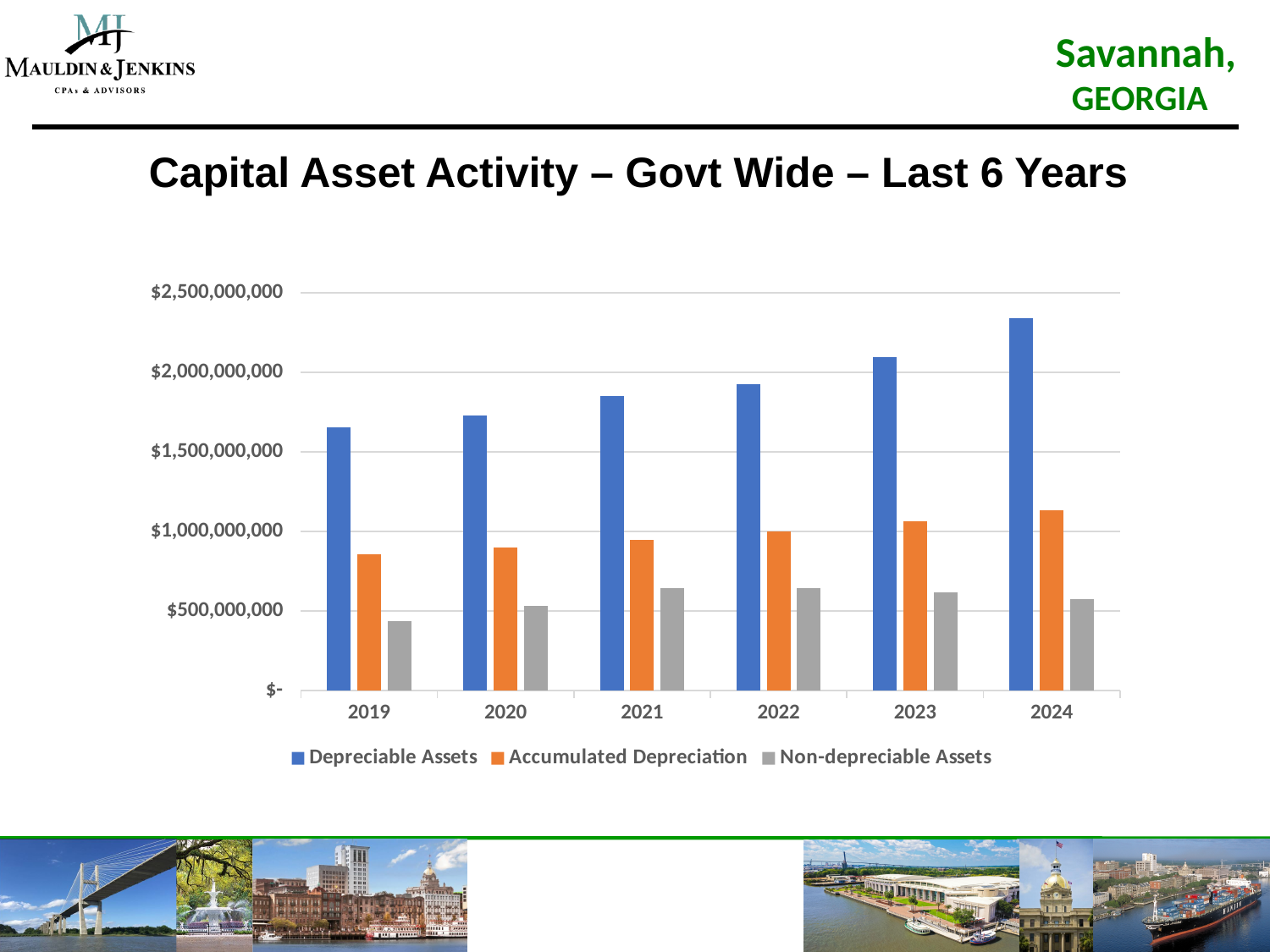
How many series does the chart's legend list? 3 Which year has the highest Depreciable Assets value? 2024 How many years are shown on the x axis of the chart? 6 Is the Depreciable Assets value for 2023 greater or less than $2,000,000,000? greater Is the Accumulated Depreciation value for 2019 greater or less than $1,000,000,000? less Which year has the lowest Non-depreciable Assets value? 2019 Which is larger in 2024: Accumulated Depreciation or Non-depreciable Assets? Accumulated Depreciation Do the Depreciable Assets values rise or fall from 2019 to 2024? Rise Which year has the lowest Depreciable Assets value? 2019 Is the Non-depreciable Assets value for 2019 greater or less than $500,000,000? less What kind of chart is shown on the slide? Bar chart What is the title of the chart on the slide? Capital Asset Activity – Govt Wide – Last 6 Years